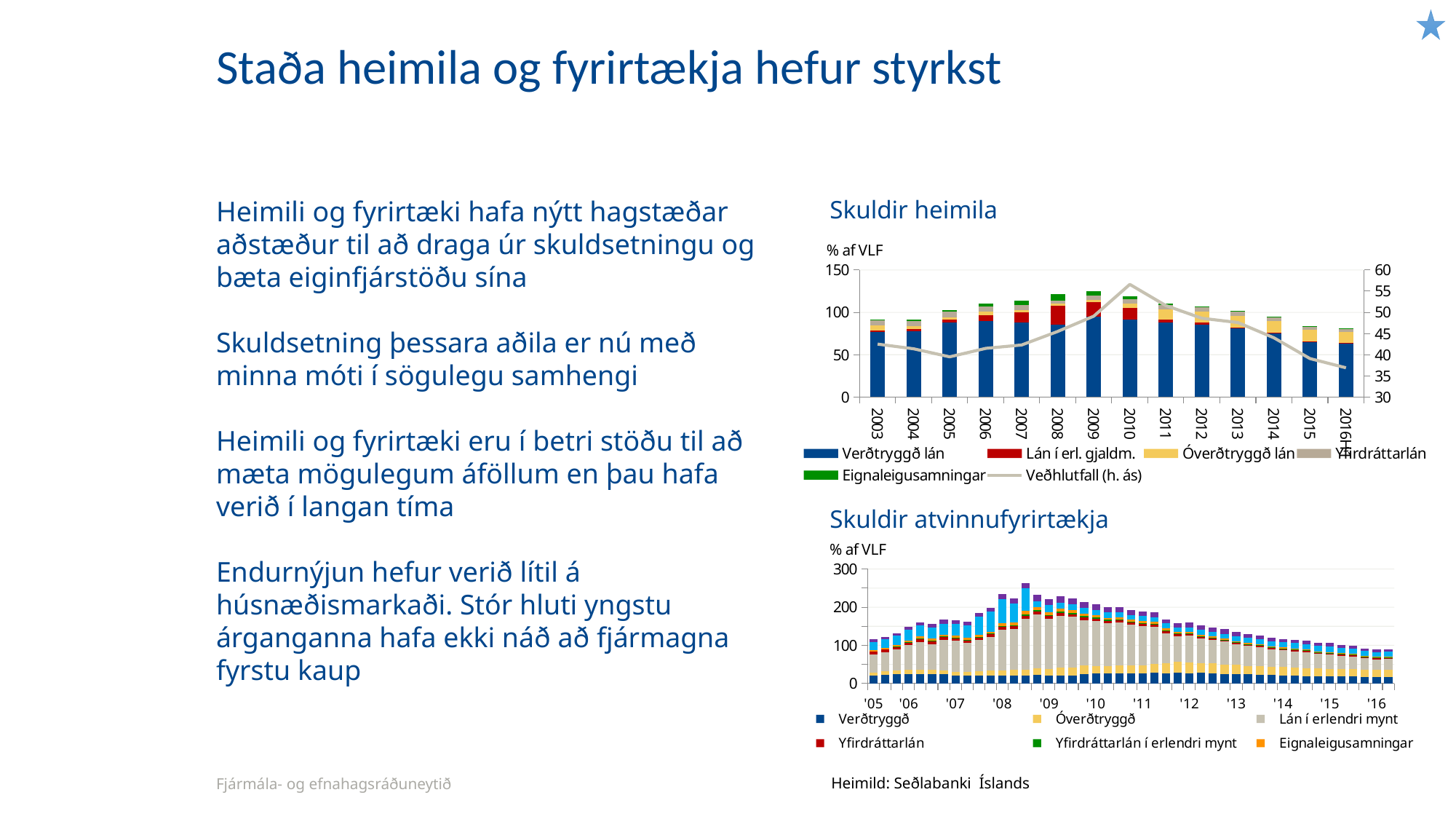
In the "Skuldir heimila" chart, how many years (categories) are shown on the x axis? 14 In the "Skuldir heimila" chart, does the Veðhlutfall (h. ás) line rise or fall from 2010 to 2016H1? fall What kind of chart is the "Skuldir atvinnufyrirtækja" chart? A stacked bar chart What kind of chart is the "Skuldir heimila" chart? A stacked bar chart with a line series In the "Skuldir atvinnufyrirtækja" chart, around which year is the tallest stacked bar? '08 How many series does the legend of the "Skuldir atvinnufyrirtækja" chart list? 6 In the "Skuldir heimila" chart, in which year does the Veðhlutfall (h. ás) line reach its highest point? 2010 How many series does the legend of the "Skuldir heimila" chart list? 6 In the "Skuldir atvinnufyrirtækja" chart, do the total stacked bars rise or fall from '08 to '16? fall In the "Skuldir atvinnufyrirtækja" chart, is the tallest stacked bar greater or less than 200? greater In the "Skuldir heimila" chart, is the total stacked bar for 2009 greater or less than 100? greater In the "Skuldir heimila" chart, is the total stacked bar for 2003 greater or less than 100? less